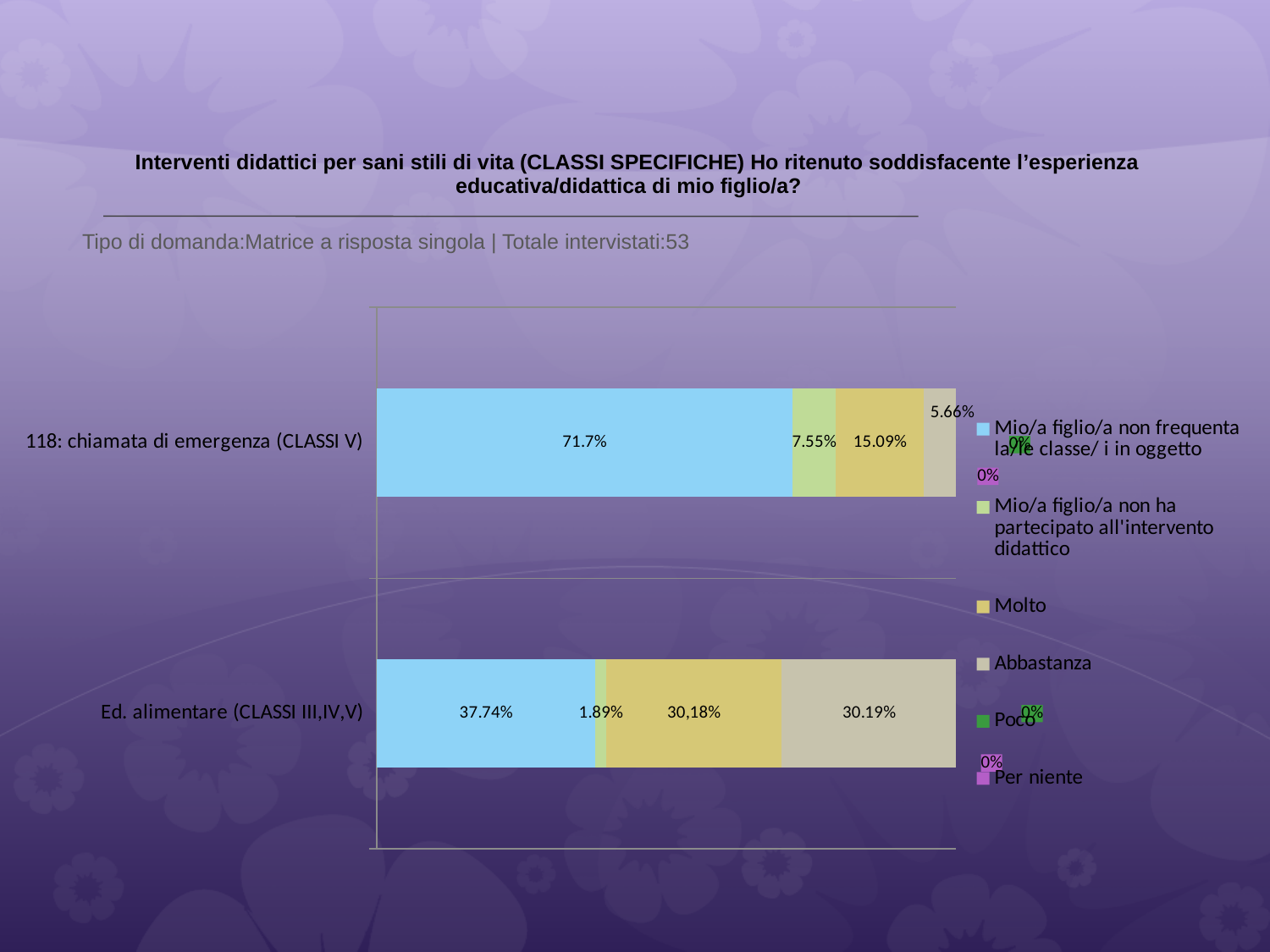
Which category has the larger 'Abbastanza' value, '118: chiamata di emergenza (CLASSI V)' or 'Ed. alimentare (CLASSI III,IV,V)'? Ed. alimentare (CLASSI III,IV,V) How many categories (rows) does the chart show? 2 How many series does the legend list? 6 What is the value of 'Mio/a figlio/a non frequenta la/le classe/ i in oggetto' for '118: chiamata di emergenza (CLASSI V)'? 71.7% What is the value of 'Mio/a figlio/a non ha partecipato all'intervento didattico' for 'Ed. alimentare (CLASSI III,IV,V)'? 1.89% What is the value of 'Abbastanza' for '118: chiamata di emergenza (CLASSI V)'? 5.66% What is the value of 'Molto' for '118: chiamata di emergenza (CLASSI V)'? 15.09% What kind of chart is shown on the slide? Stacked bar chart What is the difference between the 'Mio/a figlio/a non frequenta la/le classe/ i in oggetto' values for '118: chiamata di emergenza (CLASSI V)' and 'Ed. alimentare (CLASSI III,IV,V)'? 33.96% Which series has the largest value for '118: chiamata di emergenza (CLASSI V)'? Mio/a figlio/a non frequenta la/le classe/ i in oggetto What is the value of 'Abbastanza' for 'Ed. alimentare (CLASSI III,IV,V)'? 30.19% What is the total number of respondents stated on the slide? 53